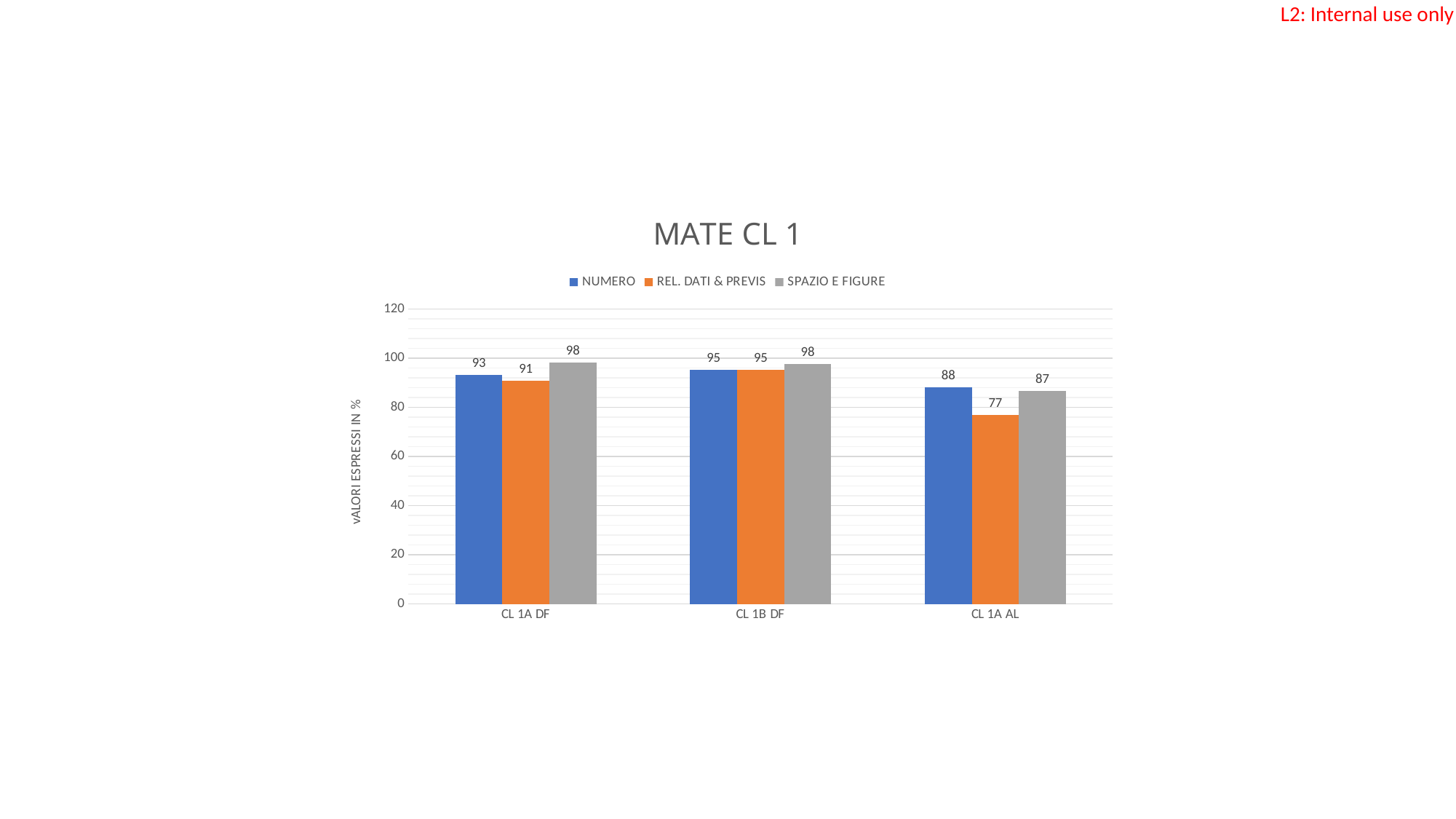
What is the NUMERO value for CL 1A DF? 93 How many series does the legend list? 3 How many categories are shown on the x axis? 3 Which is larger for CL 1A DF: NUMERO or SPAZIO E FIGURE? SPAZIO E FIGURE What is the REL. DATI & PREVIS value for CL 1A AL? 77 What kind of chart is shown? Bar chart Which category has the highest NUMERO value? CL 1B DF What is the label of the vertical axis? vALORI ESPRESSI IN % What is the title of the chart? MATE CL 1 What is the SPAZIO E FIGURE value for CL 1B DF? 98 What is the difference between the NUMERO and REL. DATI & PREVIS values for CL 1A AL? 11 Which category has the lowest REL. DATI & PREVIS value? CL 1A AL